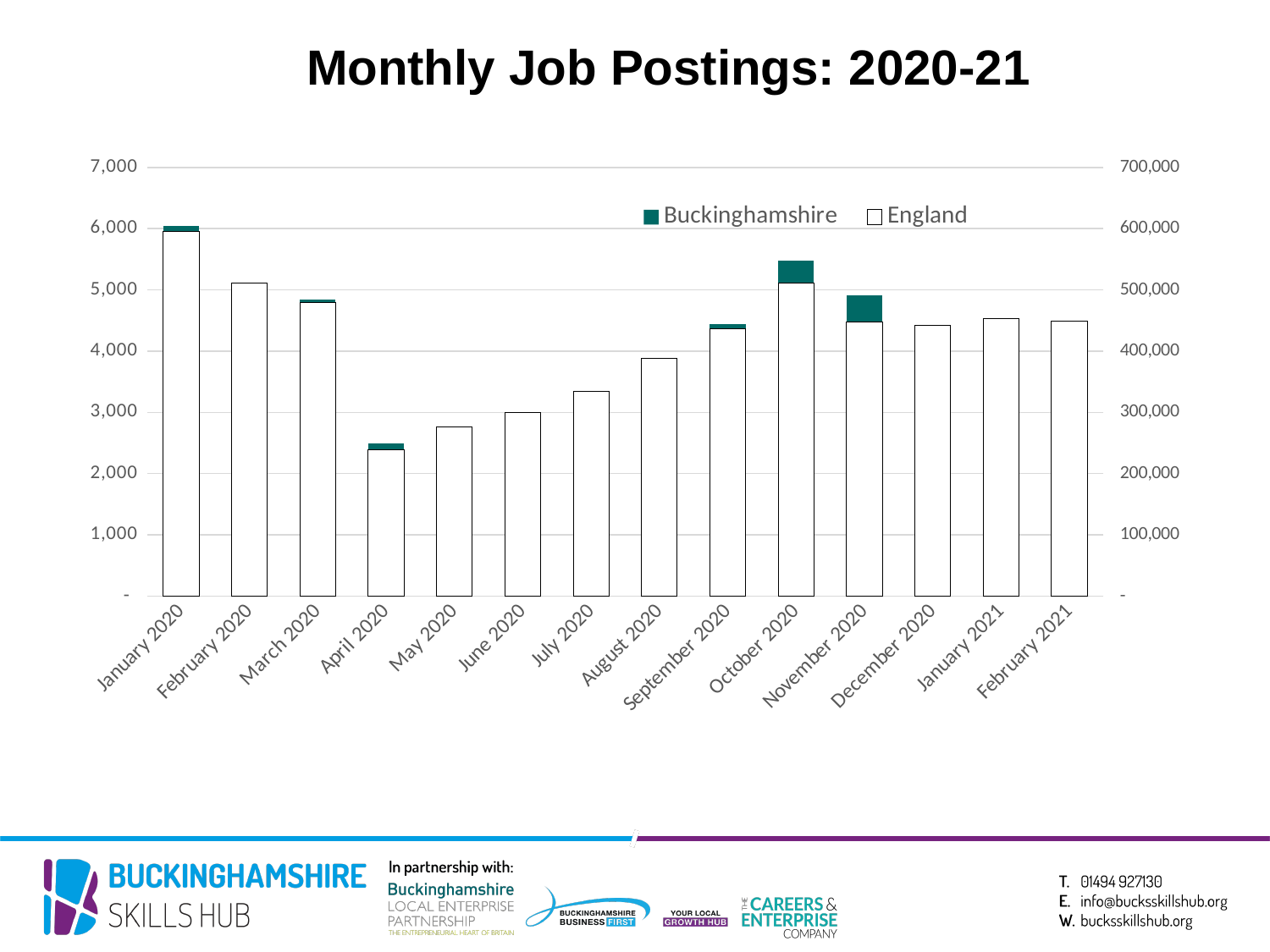
Which is larger for England: January 2020 or February 2020? January 2020 How many months are plotted along the x axis? 14 What kind of chart is shown on the slide? Bar chart Is the England value for April 2020 greater or less than 300,000? less Is the Buckinghamshire value for October 2020 greater or less than 5,000? greater Do the England job postings rise or fall from April 2020 to October 2020? rise Which month has the lowest England job postings? April 2020 Is the England value for January 2020 greater or less than 500,000? greater How many series does the legend list? 2 What is the title of the chart? Monthly Job Postings: 2020-21 Which series is shown in teal in the legend? Buckinghamshire Which month has the highest England job postings? January 2020